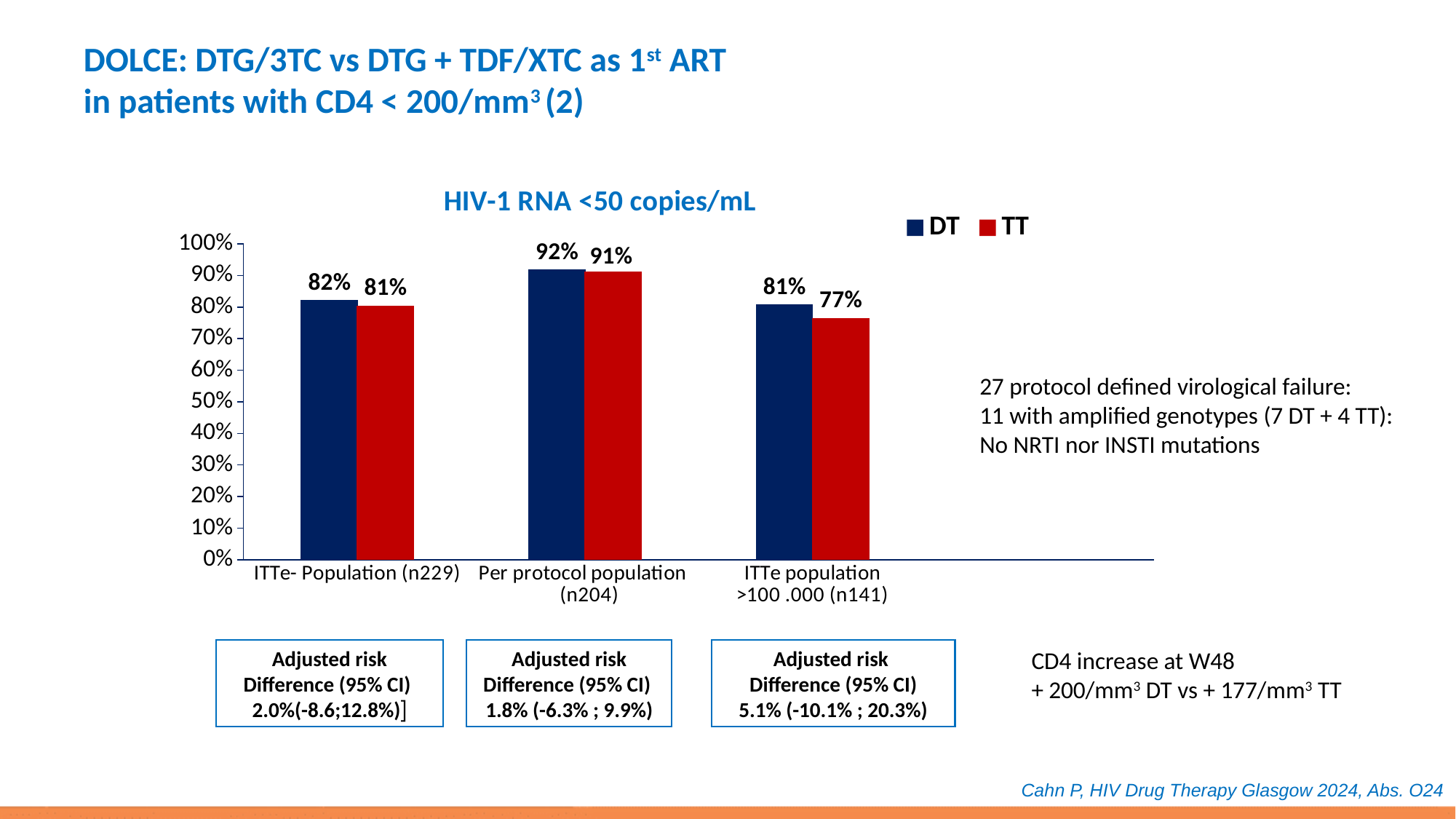
What is the DT value for the Per protocol population (n204) category? 92% What is the difference between the DT and TT values for the ITTe population >100 .000 (n141) category? 4% What is the DT value for the ITTe- Population (n229) category? 82% What is the TT value for the ITTe population >100 .000 (n141) category? 77% What is the TT value for the Per protocol population (n204) category? 91% Which category has the lowest TT value? ITTe population >100 .000 (n141) What kind of chart is shown on the slide? Bar chart What is the title of the chart? HIV-1 RNA <50 copies/mL Which category has the highest DT value? Per protocol population (n204) How many categories are shown on the x axis? 3 Which is larger for the ITTe population >100 .000 (n141) category, the DT value or the TT value? DT How many series does the legend list? 2